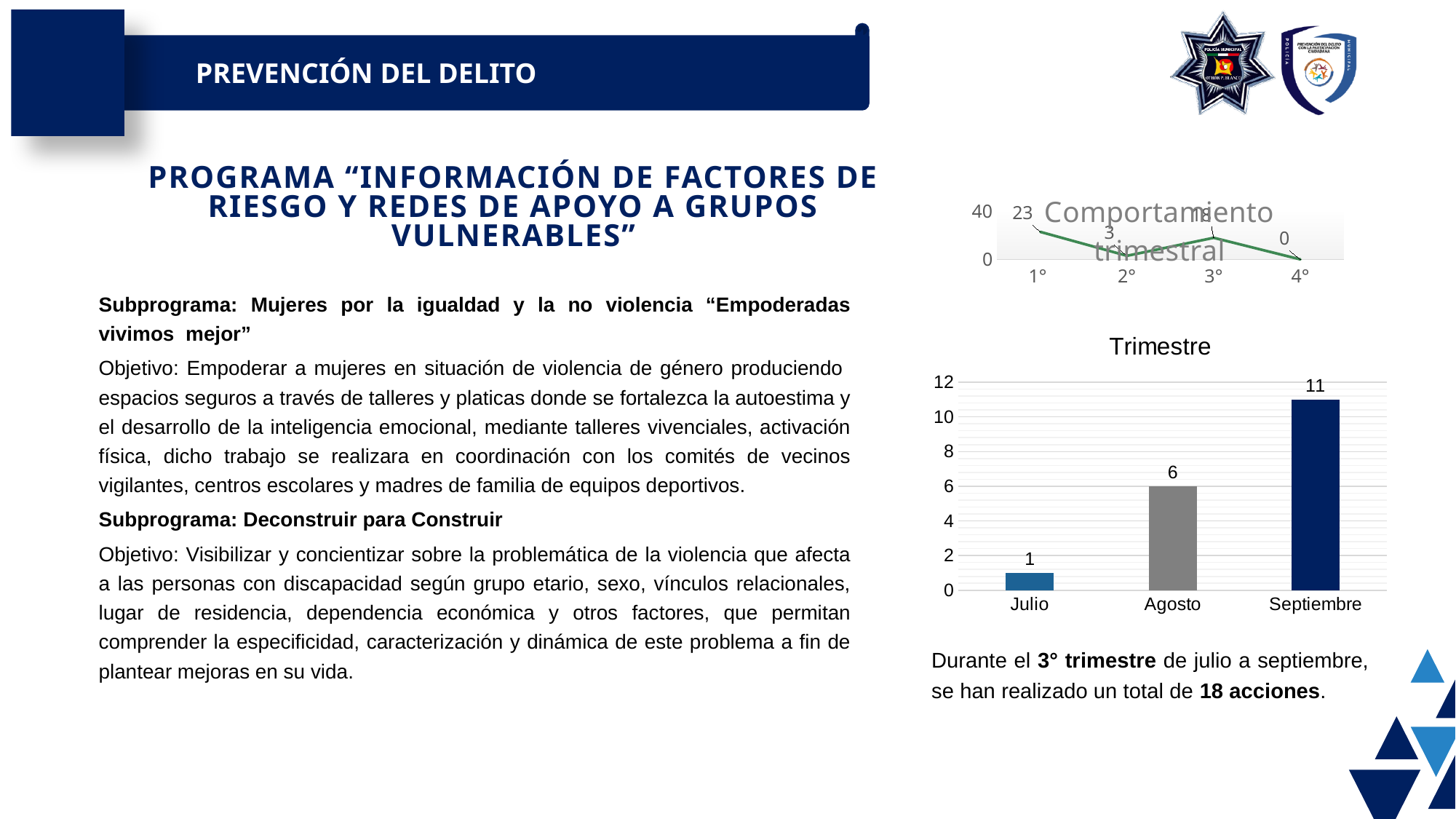
In the 'Trimestre' bar chart, what is the value for Agosto? 6 In the 'Trimestre' bar chart, what is the value for Septiembre? 11 In the 'Trimestre' bar chart, which month has the lowest value? Julio In the 'Trimestre' bar chart, which month has the highest value? Septiembre In the 'Comportamiento trimestral' line chart, what is the value for 4°? 0 In the 'Trimestre' bar chart, do the values rise or fall from Julio to Septiembre? rise In the 'Comportamiento trimestral' line chart, what is the value for 1°? 23 In the 'Trimestre' bar chart, how many months are shown? 3 In the 'Trimestre' bar chart, what is the difference between the values for Septiembre and Agosto? 5 What kind of chart is the 'Trimestre' chart? bar chart In the 'Comportamiento trimestral' line chart, which is larger, the value for 1° or the value for 2°? 1° In the 'Trimestre' bar chart, what is the value for Julio? 1